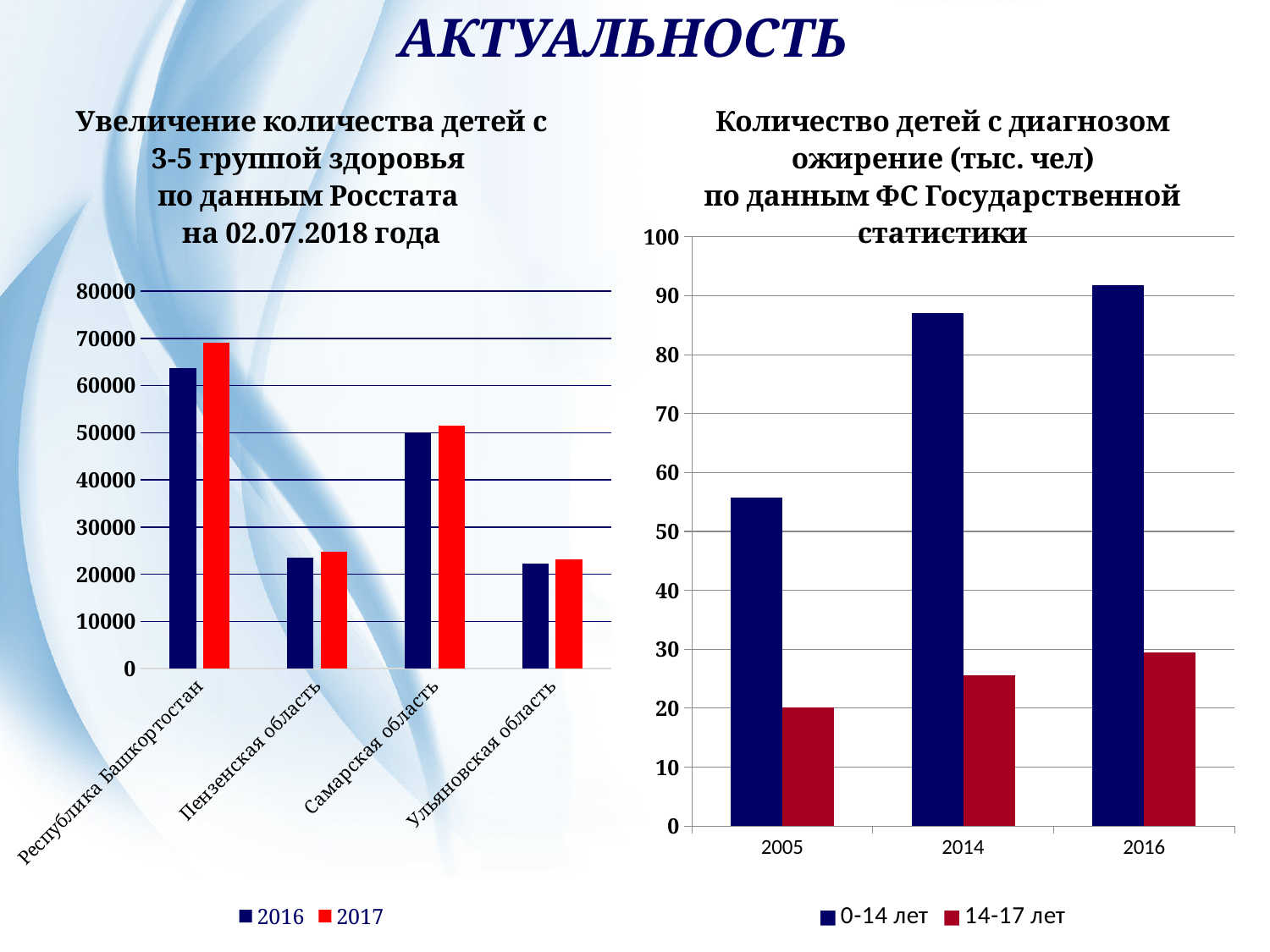
How many years are shown on the x axis of the right chart? 3 In the right chart, which year has the lowest value for the 0-14 лет series? 2005 In the left chart, which region has the highest value for 2017? Республика Башкортостан In the left chart, is the 2017 value for Пензенская область greater or less than 30000? less In the right chart, do the values for the 14-17 лет series rise or fall from 2005 to 2016? rise In the right chart, is the 0-14 лет value for 2016 greater or less than 90? greater How many series does the legend of the left chart list? 2 How many regions are shown on the x axis of the left chart? 4 What kind of chart is the right chart, titled "Количество детей с диагнозом ожирение"? bar chart In the left chart, is the 2016 value for Республика Башкортостан greater or less than 60000? greater In the left chart, which is larger for Самарская область: the 2016 value or the 2017 value? 2017 What kind of chart is the left chart, titled "Увеличение количества детей с 3-5 группой здоровья"? bar chart